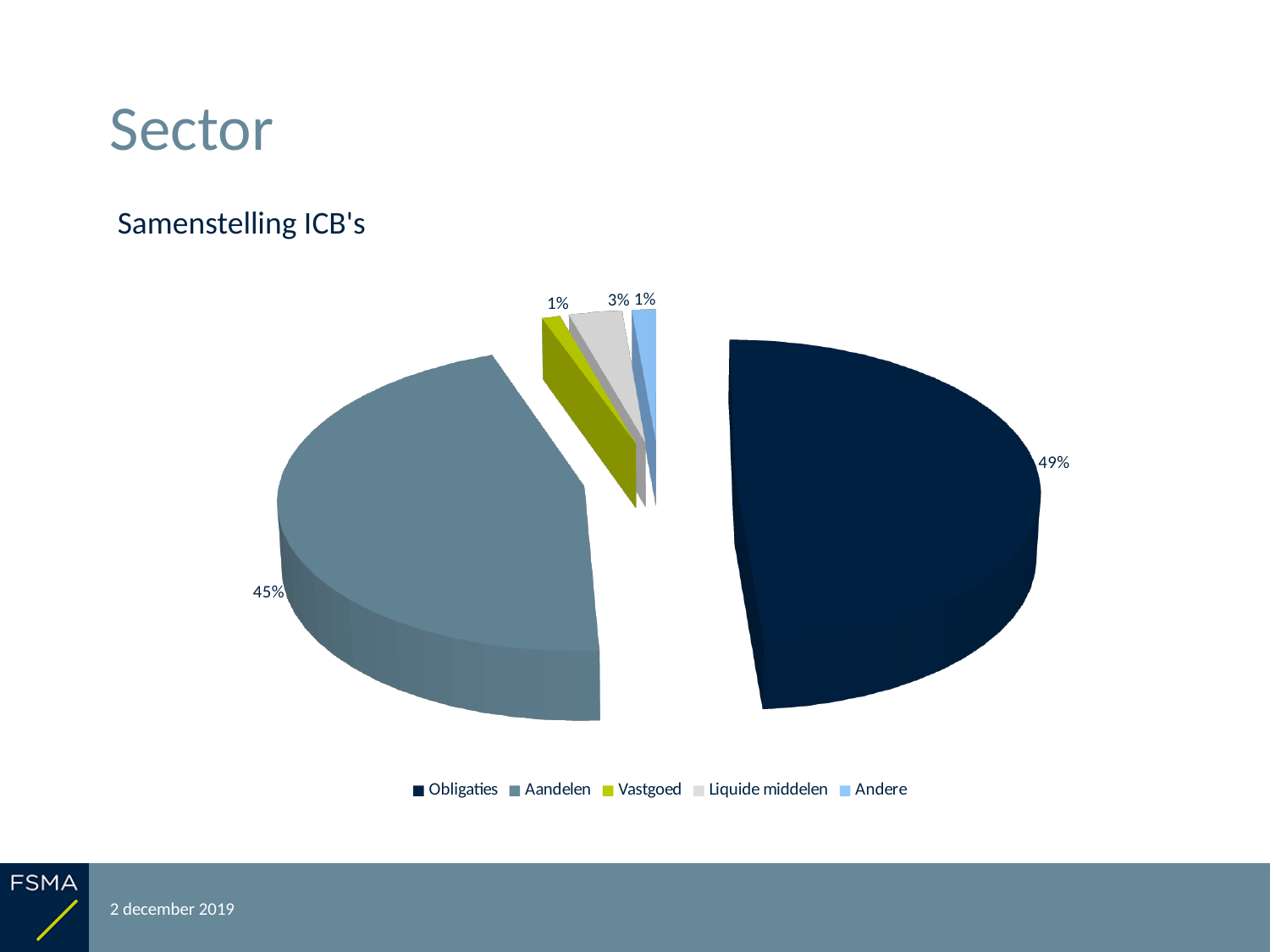
What is the value shown for Liquide middelen? 3% What is the difference between the shares of Obligaties and Aandelen? 4% What is the title of the chart? Samenstelling ICB's What is the value shown for Vastgoed? 1% What share of the pie does Obligaties represent? 49% What share of the pie does Aandelen represent? 45% How many categories does the pie chart show? 5 Which category has the largest slice of the pie? Obligaties What is the value shown for Andere? 1% What type of chart is shown on the slide? pie chart How many entries does the legend list? 5 Which is larger, the share for Liquide middelen or the share for Vastgoed? Liquide middelen